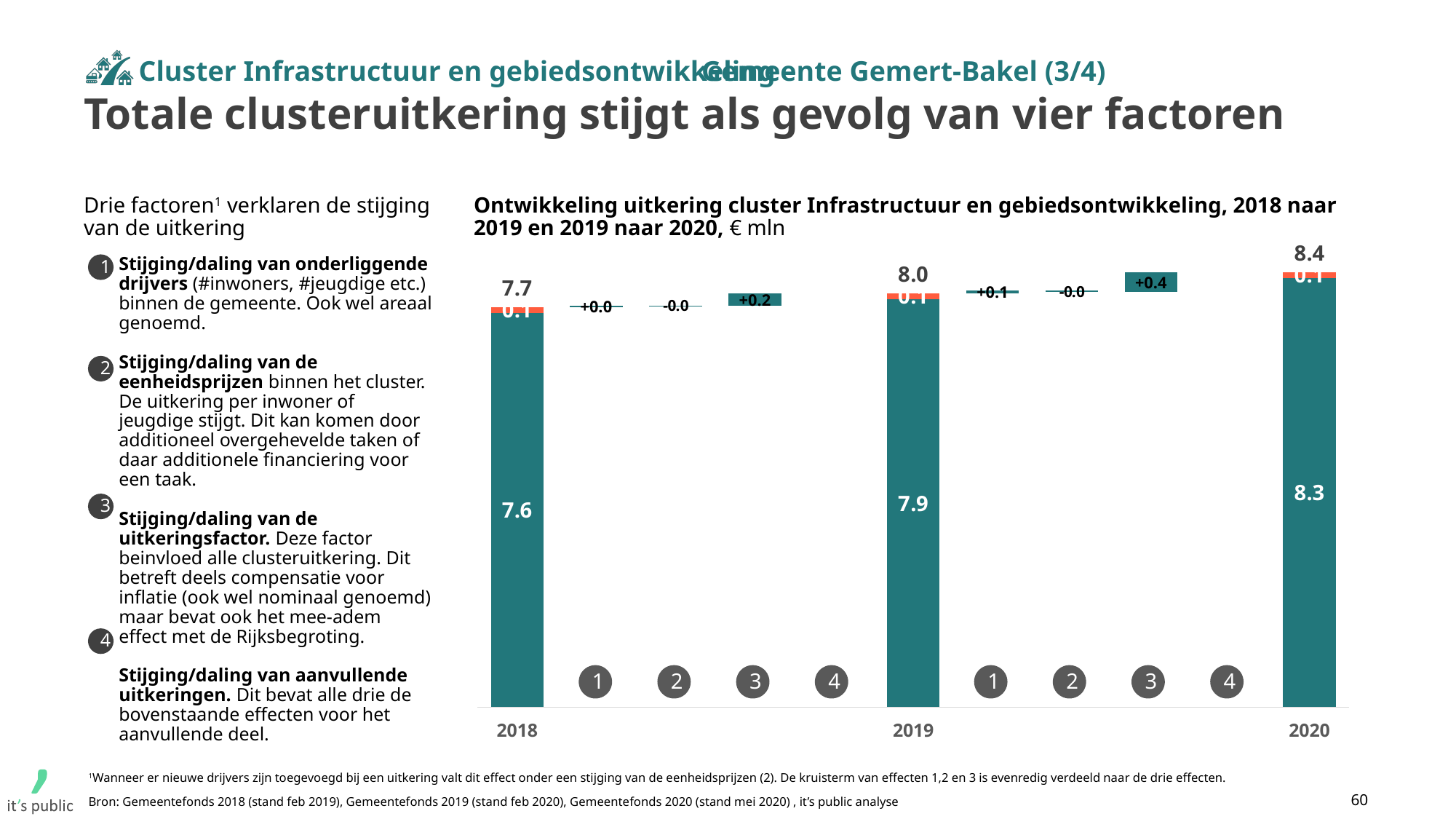
What is the total cluster payment shown for 2020? 8.4 Which year has the lowest total cluster payment? 2018 Do the total cluster payments rise or fall from 2018 to 2020? rise In what unit are the values in the chart expressed, according to the chart title? € mln What is the value of the large teal segment of the 2020 bar? 8.3 What is the total cluster payment shown for 2019? 8.0 Which year has the highest total cluster payment? 2020 What is the effect of factor 3 (uitkeringsfactor) from 2019 to 2020? +0.4 What is the value of the large teal segment of the 2019 bar? 7.9 What is the difference between the 2020 total (8.4) and the 2018 total (7.7)? 0.7 What is the effect of factor 3 (uitkeringsfactor) from 2018 to 2019? +0.2 What is the total cluster payment shown for 2018? 7.7